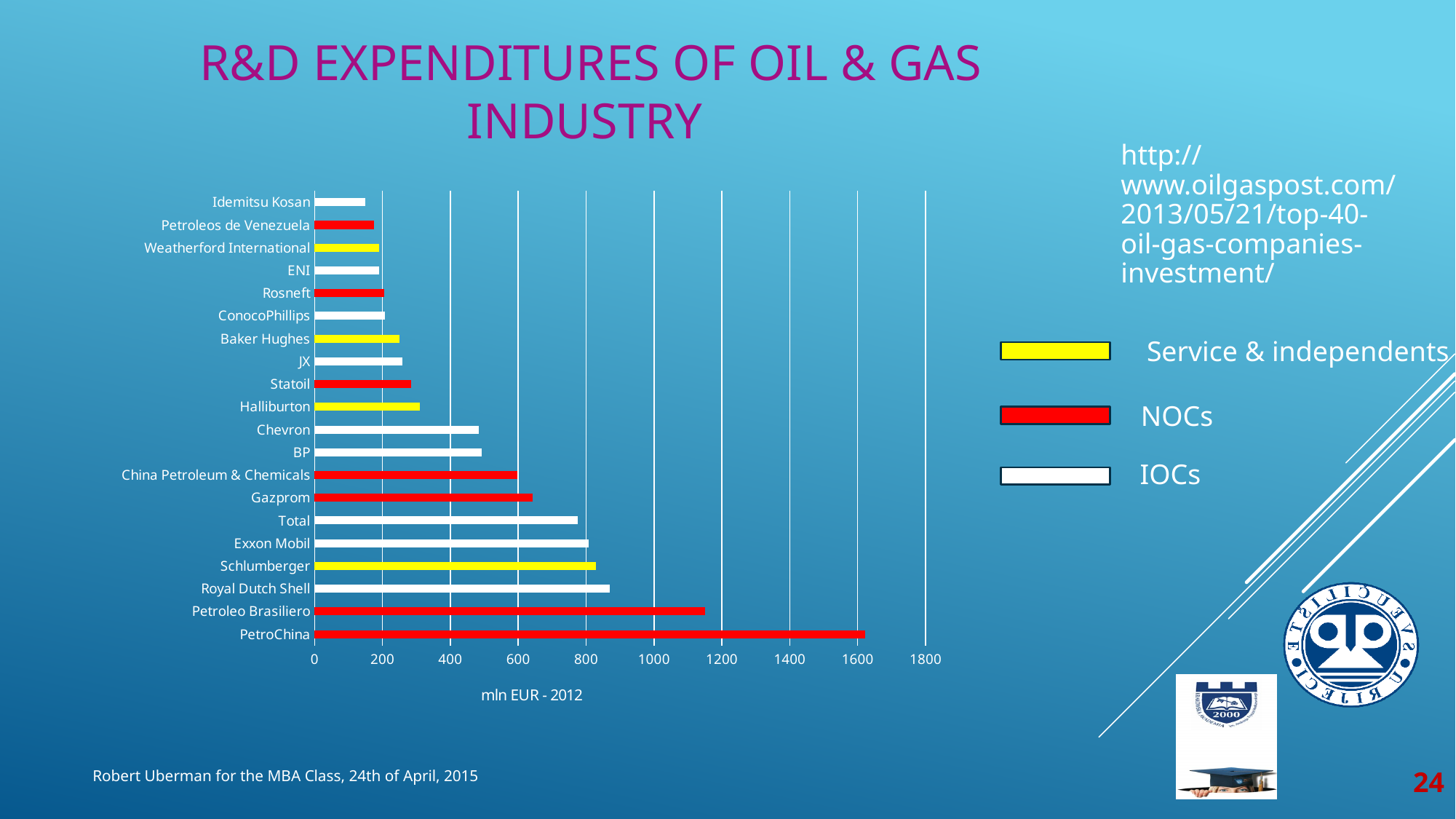
What is the label of the horizontal axis of the chart? mln EUR - 2012 Is the value for Halliburton greater or less than 200? greater Is the value for Chevron greater or less than 600? less Is the value for PetroChina greater or less than 1400? greater How many companies are plotted in the chart? 20 Which company has the lowest R&D expenditure in the chart? Idemitsu Kosan Which company has the highest R&D expenditure in the chart? PetroChina What kind of chart is shown on the slide? bar chart According to the legend, which group of companies is shown with red bars? NOCs Which has the larger R&D expenditure, Schlumberger or Halliburton? Schlumberger